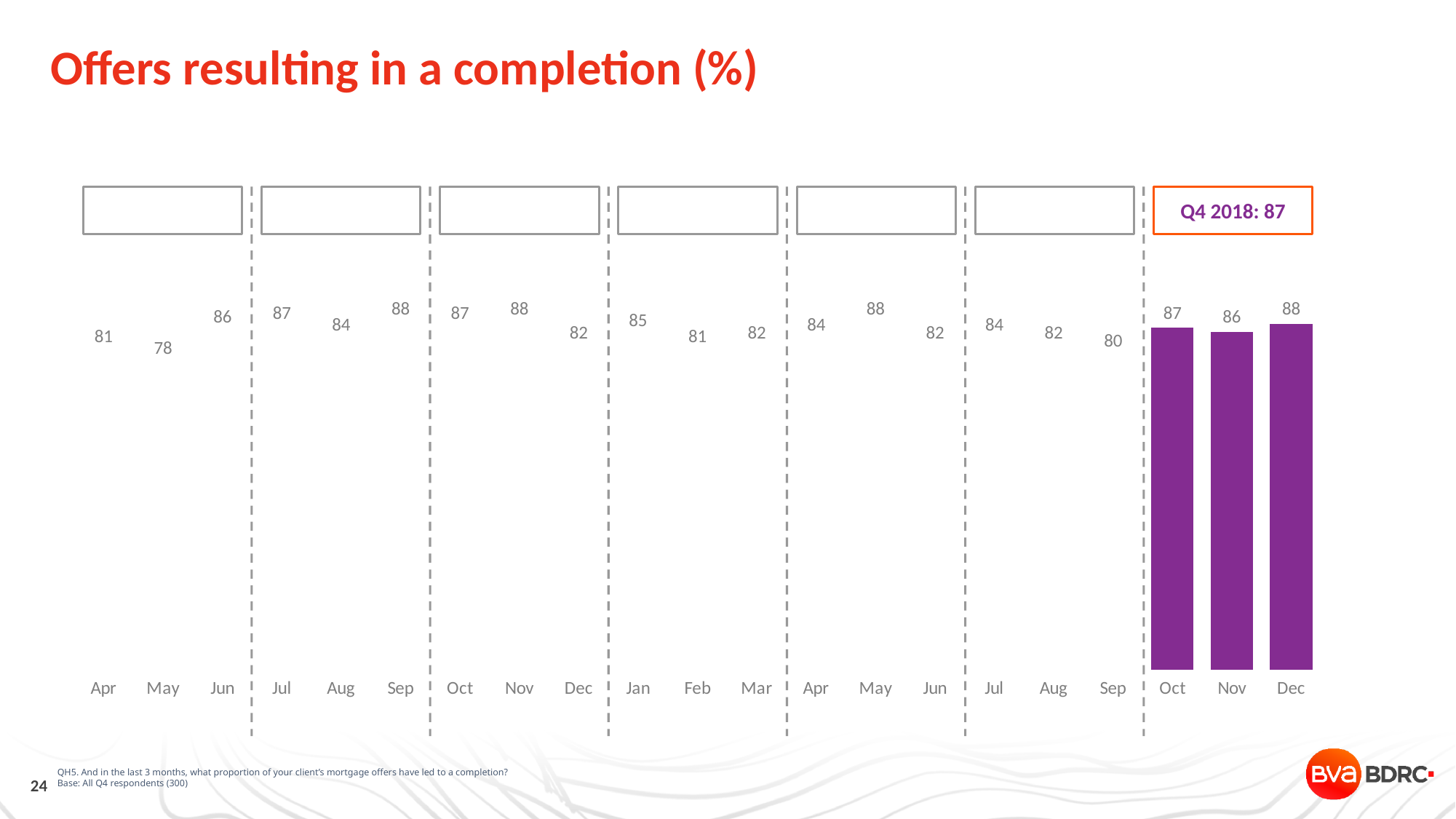
What is the value for Dec in the Q4 2018 group (rightmost bar)? 88 What figure is shown in the highlighted box labelled Q4 2018? 87 In the Q4 2018 group, which is larger, Oct or Nov? Oct What is the value for the first May on the x axis (leftmost group)? 78 What is the value for Jan? 85 What is the difference between the Dec and Nov values in the Q4 2018 group? 2 What is the lowest value labelled on the chart? 78 How many months are labelled along the x axis? 21 What kind of chart is shown on the slide? Bar chart What is the value for the second Sep on the x axis (the group just before Q4 2018)? 80 What is the highest value labelled on the chart? 88 What is the value for Nov in the Q4 2018 group? 86